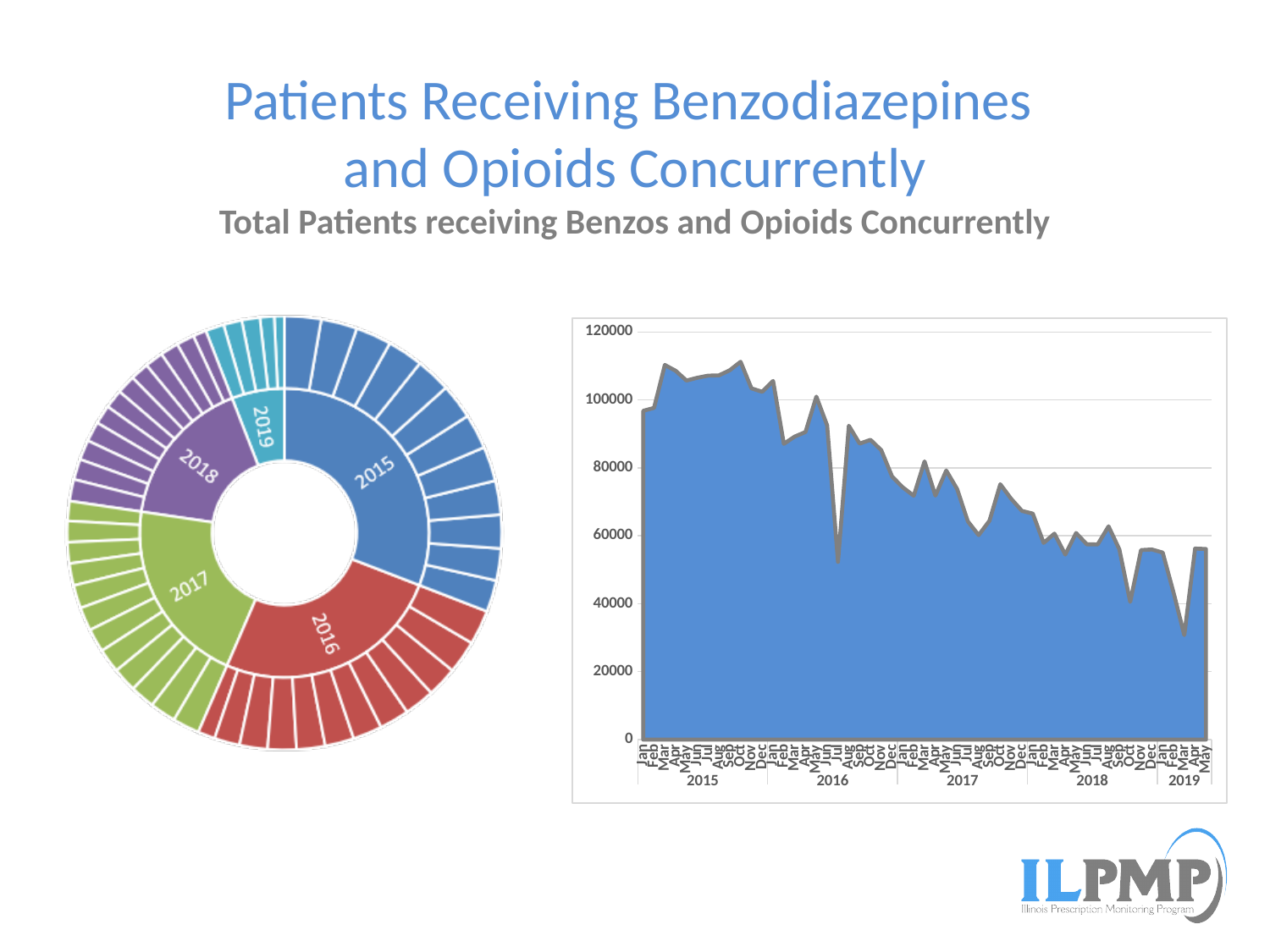
In the chart on the left, which year takes the largest share of the inner ring? 2015 In the chart on the right, which month has the lowest value? Mar 2019 In the chart on the right, is the value for Jul 2016 greater or less than 60000? less In the chart on the right, do the values generally rise or fall from 2015 to 2019? fall What kind of chart is the chart on the left of the slide? sunburst chart In the chart on the left, what colour is the segment for 2017? green How many years are labelled along the x axis of the chart on the right? 5 In the chart on the right, is the value for Jan 2015 greater or less than 80000? greater In the chart on the right, is the value for Mar 2019 greater or less than 40000? less What kind of chart is the chart on the right of the slide? area chart In the chart on the right, which is larger, the value for Jan 2015 or the value for May 2019? Jan 2015 In the chart on the left, which year takes the smallest share of the inner ring? 2019